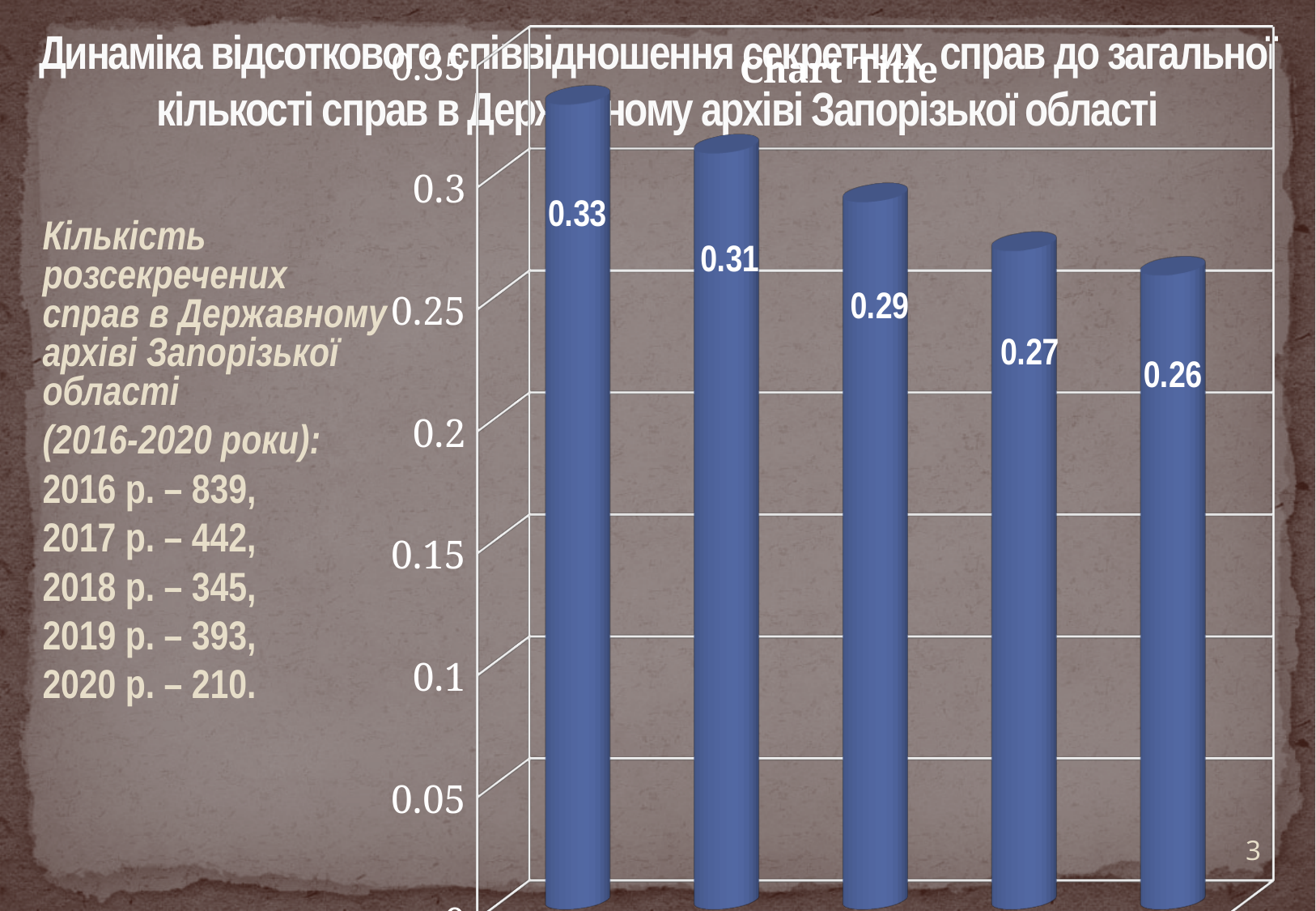
Do the values rise or fall from left to right across the bars? fall What is the difference between the first bar (0.33) and the last bar (0.26)? 0.07 What is the value shown on the first (leftmost) bar? 0.33 What kind of chart is shown on the slide? bar chart How many bars are plotted in the chart? 5 Which is larger, the second bar or the fourth bar? the second bar (0.31) Is the value of the fourth bar greater or less than 0.3? less What is the value shown on the third bar from the left? 0.29 Which bar has the lowest value? the last (rightmost) bar, 0.26 What is the value shown on the last (rightmost) bar? 0.26 Which bar has the highest value? the first (leftmost) bar, 0.33 What title is printed above the chart's plot area? Chart Title